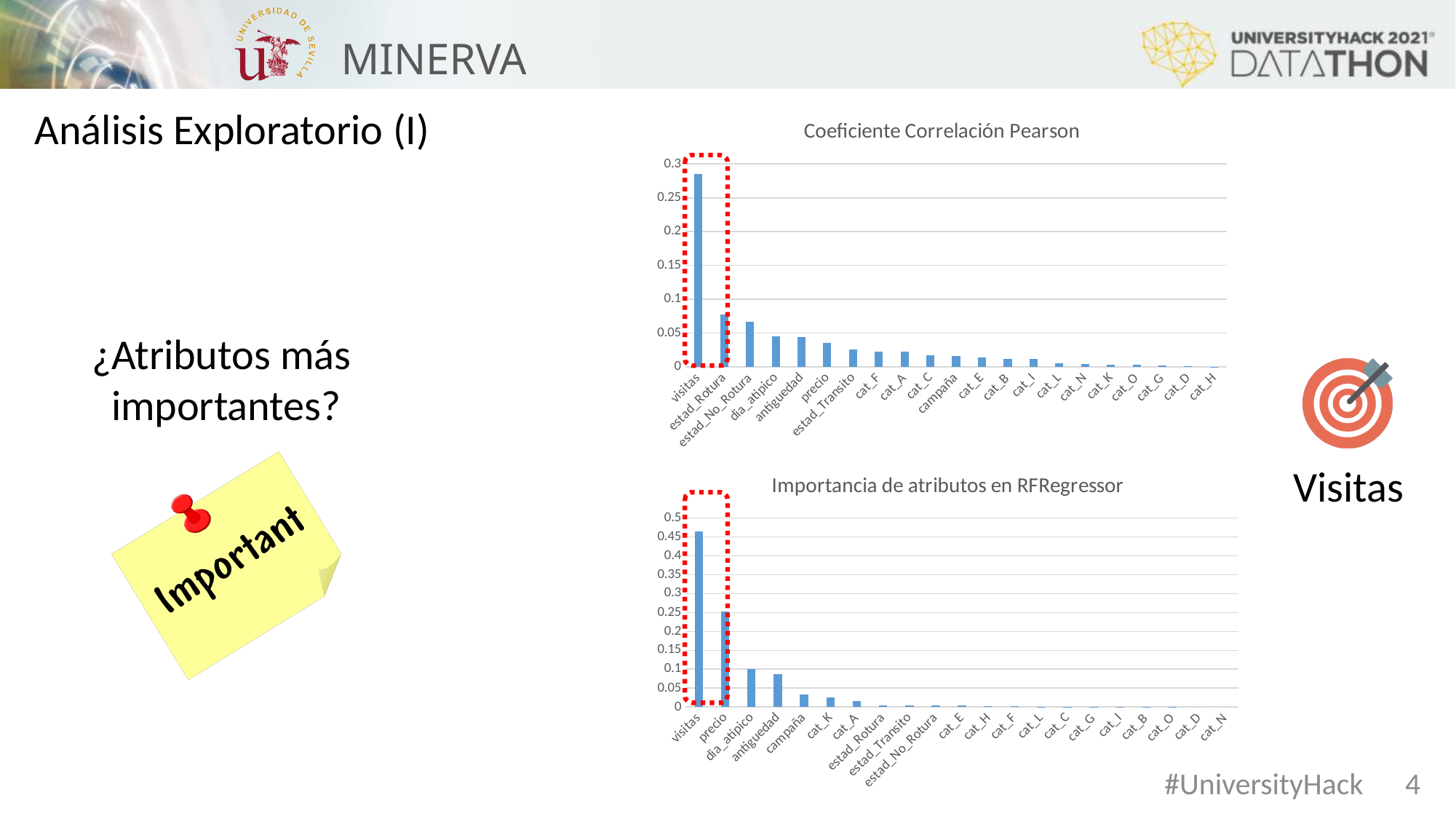
In the 'Importancia de atributos en RFRegressor' chart, which is larger, the value for visitas or the value for precio? visitas In the 'Coeficiente Correlación Pearson' chart, is the value for visitas greater or less than 0.25? greater In the 'Importancia de atributos en RFRegressor' chart, which category has the highest value? visitas How many categories are shown on the x axis of the 'Importancia de atributos en RFRegressor' chart? 21 What is the title of the lower chart on the slide? Importancia de atributos en RFRegressor In the 'Coeficiente Correlación Pearson' chart, do the values rise or fall from left to right along the x axis? fall In the 'Coeficiente Correlación Pearson' chart, which category has the highest value? visitas How many categories are shown on the x axis of the 'Coeficiente Correlación Pearson' chart? 21 In the 'Importancia de atributos en RFRegressor' chart, is the value for antiguedad greater or less than 0.1? less In the 'Importancia de atributos en RFRegressor' chart, is the value for visitas greater or less than 0.4? greater What type of chart is the 'Coeficiente Correlación Pearson' chart? bar chart